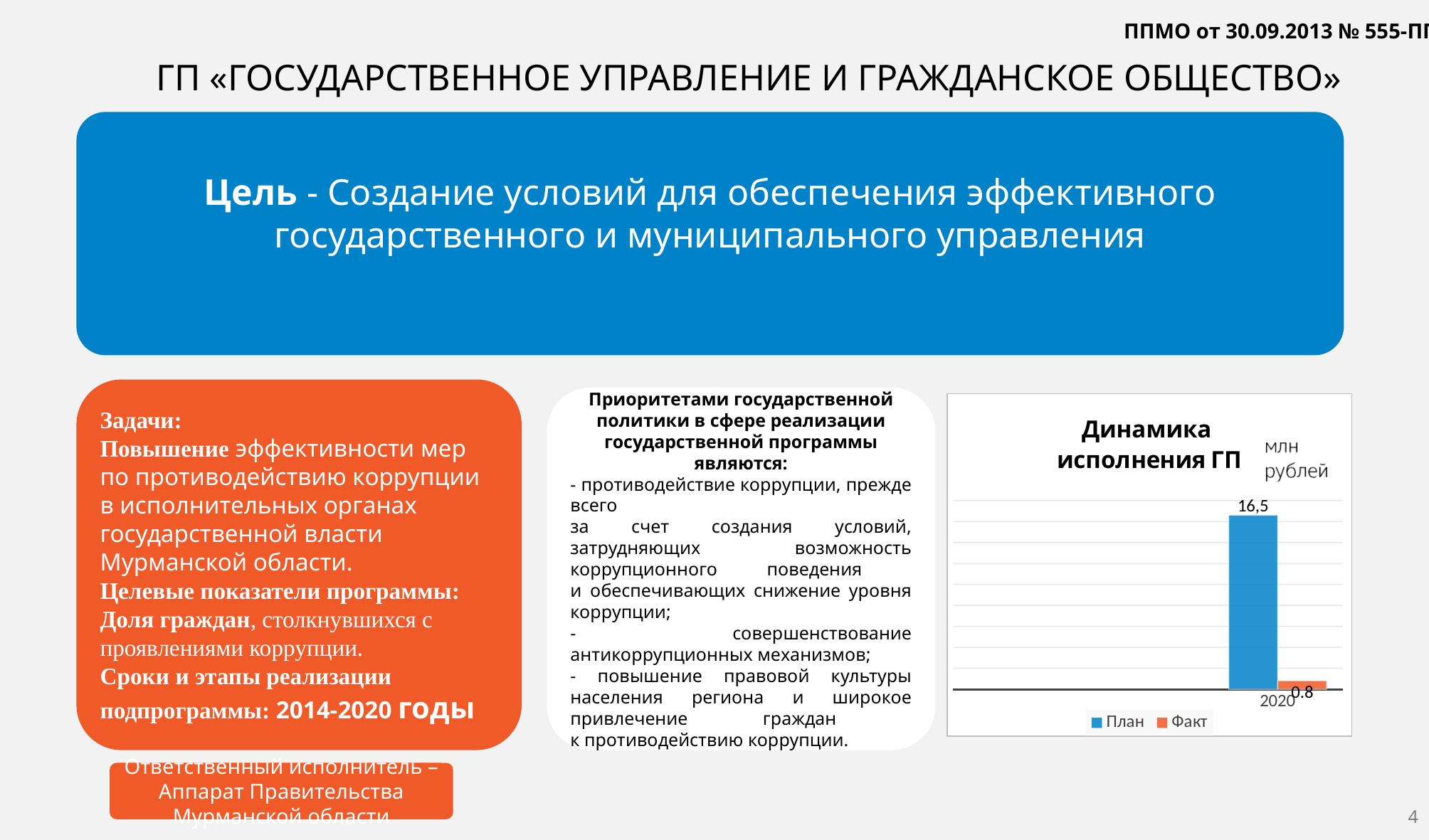
In the chart «Динамика исполнения ГП», which series has the higher value for 2020, План or Факт? План In the chart «Динамика исполнения ГП», which series has the highest value for 2020? План How many categories are shown on the x axis of the chart «Динамика исполнения ГП»? 1 What is the title of the chart on the slide? Динамика исполнения ГП Which year is shown on the x axis of the chart «Динамика исполнения ГП»? 2020 In the chart «Динамика исполнения ГП», what is the value of the План series for 2020? 16,5 How many series does the legend of the chart «Динамика исполнения ГП» list? 2 Which series are listed in the legend of the chart «Динамика исполнения ГП»? План, Факт What unit of measurement is indicated next to the title of the chart «Динамика исполнения ГП»? млн рублей What type of chart is shown under the title «Динамика исполнения ГП»? bar chart In the chart «Динамика исполнения ГП», which series has the lowest value for 2020? Факт